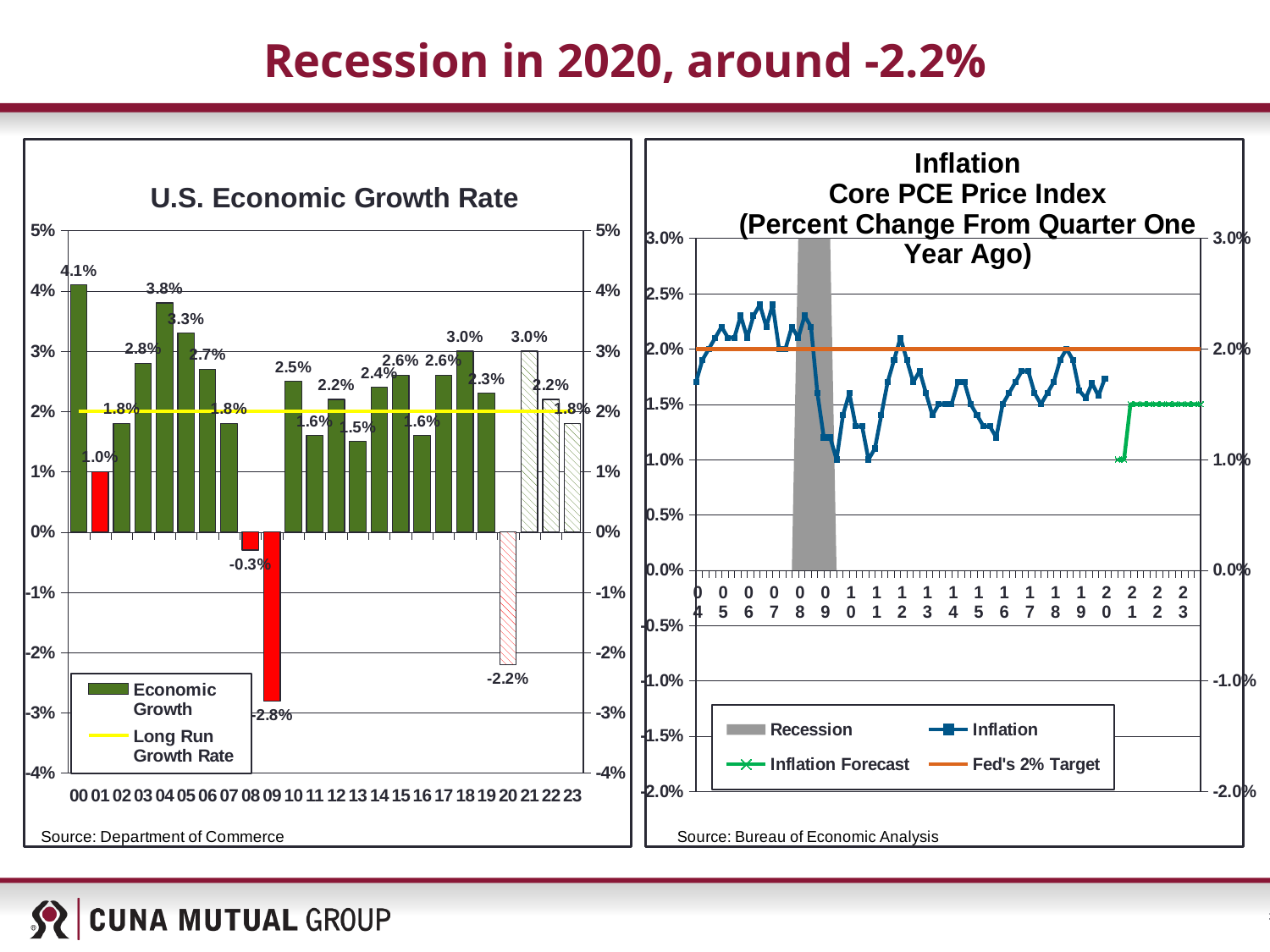
What kind of chart is the U.S. Economic Growth Rate chart? bar chart On the U.S. Economic Growth Rate chart, which year has the lowest growth rate? 2009 On the U.S. Economic Growth Rate chart, what is the value for 2000? 4.1% How many entries does the legend of the Inflation chart on the right list? 4 On the U.S. Economic Growth Rate chart, what is the difference between the values for 2004 and 2005? 0.5 percentage points On the U.S. Economic Growth Rate chart, do the values rise or fall from 2004 to 2007? fall On the Inflation chart on the right, is the inflation value in 2015 greater or less than 2.0%? less How many years are shown on the U.S. Economic Growth Rate chart? 24 On the U.S. Economic Growth Rate chart, which year has the highest growth rate? 2000 On the U.S. Economic Growth Rate chart, which year has the larger value, 2012 or 2013? 2012 On the U.S. Economic Growth Rate chart, what is the value for 2020? -2.2%